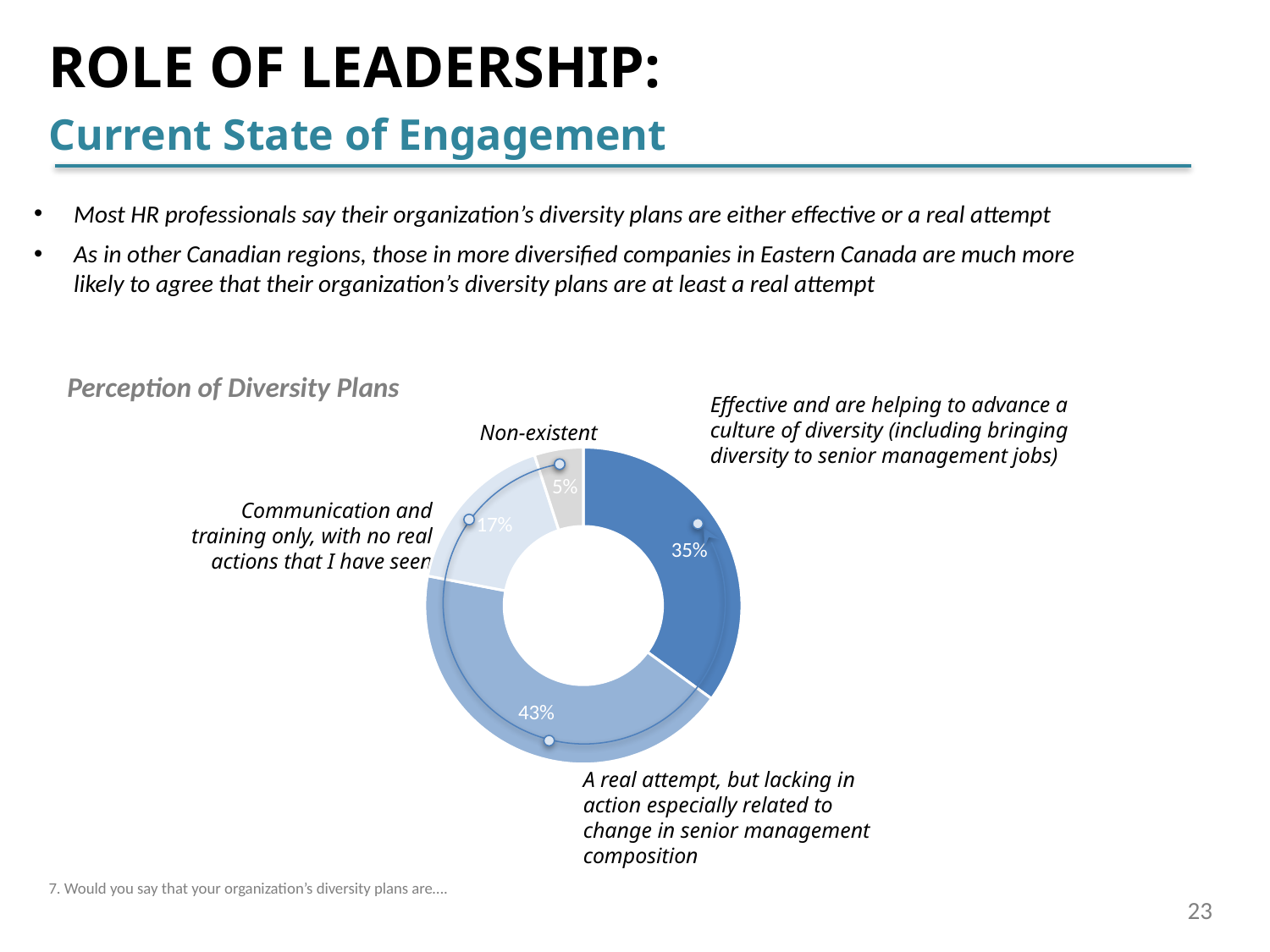
Which perception of diversity plans has the largest share in the chart? A real attempt, but lacking in action What percentage of respondents say their organization's diversity plans are a real attempt, but lacking in action? 43% What kind of chart is used to show the Perception of Diversity Plans? Doughnut chart Which perception of diversity plans has the smallest share in the chart? Non-existent What percentage of respondents say their diversity plans are effective and helping to advance a culture of diversity? 35% Which is larger: the share for 'Communication and training only' or the share for 'Non-existent'? Communication and training only What is the combined share of respondents who say their diversity plans are either effective or a real attempt? 78% What share of respondents say their diversity plans are communication and training only, with no real actions? 17% What is the title of the chart on the slide? Perception of Diversity Plans How many categories are shown in the Perception of Diversity Plans chart? 4 What percentage of respondents say their organization's diversity plans are non-existent? 5% What is the difference in percentage points between 'A real attempt, but lacking in action' and 'Effective and are helping to advance a culture of diversity'? 8 percentage points